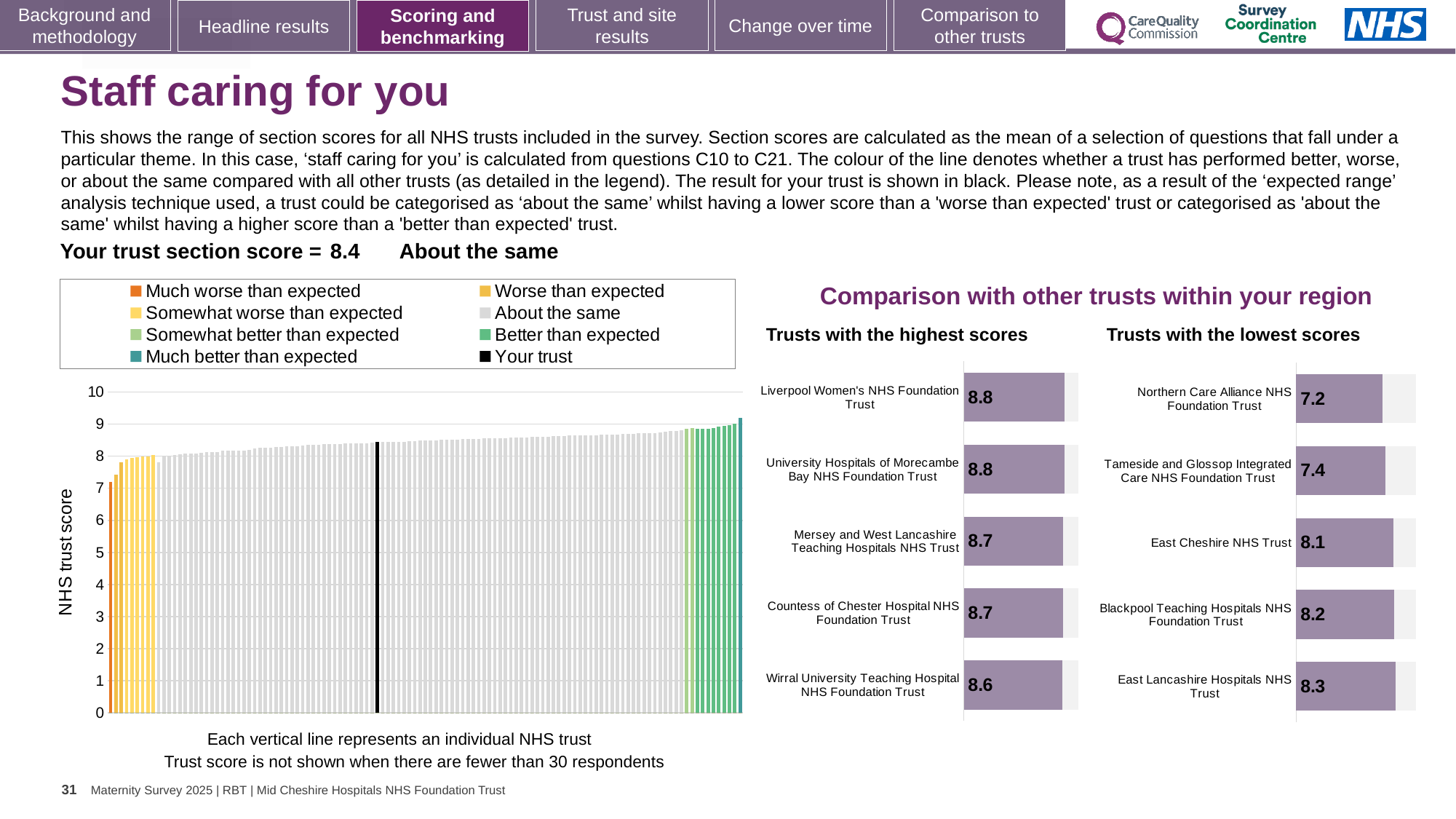
In the 'Trusts with the lowest scores' chart, which trust has the lowest score? Northern Care Alliance NHS Foundation Trust In the 'Trusts with the highest scores' chart, what is the score for Wirral University Teaching Hospital NHS Foundation Trust? 8.6 How many entries does the legend above the large chart on the left list? 8 In the large chart on the left, what is the label on the vertical axis? NHS trust score What is the section score for your trust shown on the slide? 8.4 In the 'Trusts with the lowest scores' chart, which has the higher score: Tameside and Glossop Integrated Care NHS Foundation Trust or Blackpool Teaching Hospitals NHS Foundation Trust? Blackpool Teaching Hospitals NHS Foundation Trust In the large chart on the left, is the value of the leftmost (orange) bar greater or less than 8? less In the 'Trusts with the highest scores' chart, how many trusts are shown? 5 In the 'Trusts with the lowest scores' chart, what is the difference between the scores of East Lancashire Hospitals NHS Trust and Northern Care Alliance NHS Foundation Trust? 1.1 In the 'Trusts with the lowest scores' chart, what is the score for East Cheshire NHS Trust? 8.1 What kind of chart is the large chart on the left showing NHS trust scores? bar chart In the large chart on the left, do the bars rise or fall from left to right? rise